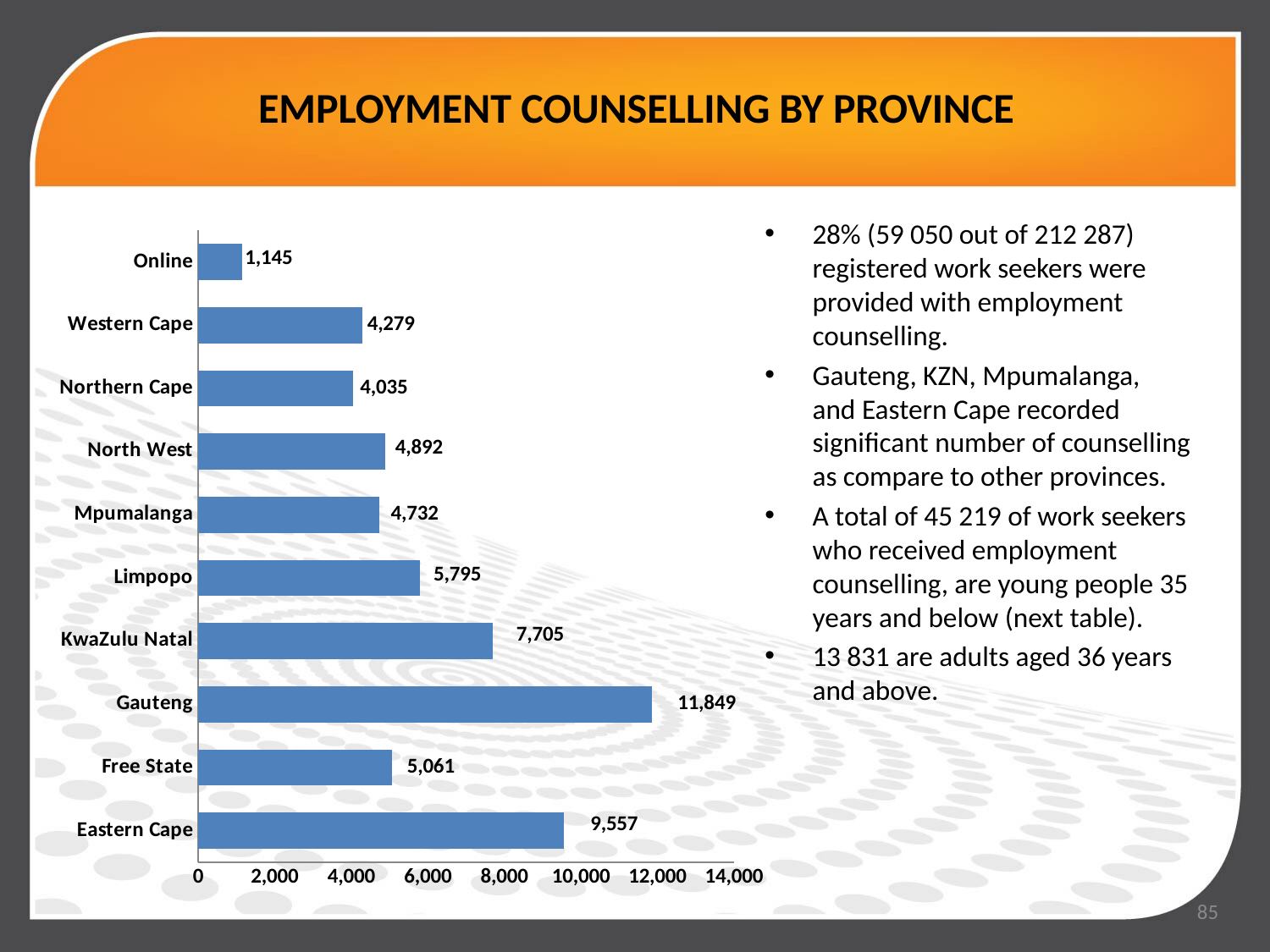
Is the value for Eastern Cape greater or less than 8,000? greater Which is larger, the value for Western Cape or the value for Northern Cape? Western Cape What is the difference between the values for Gauteng and KwaZulu Natal? 4,144 How many categories are shown in the chart? 10 Which category has the lowest value? Online What is the value for Limpopo? 5,795 What is the title of the slide containing the chart? EMPLOYMENT COUNSELLING BY PROVINCE What is the value for Gauteng? 11,849 Which category has the highest value? Gauteng What kind of chart is shown on the slide? Bar chart What is the value for Eastern Cape? 9,557 What is the value for Online? 1,145